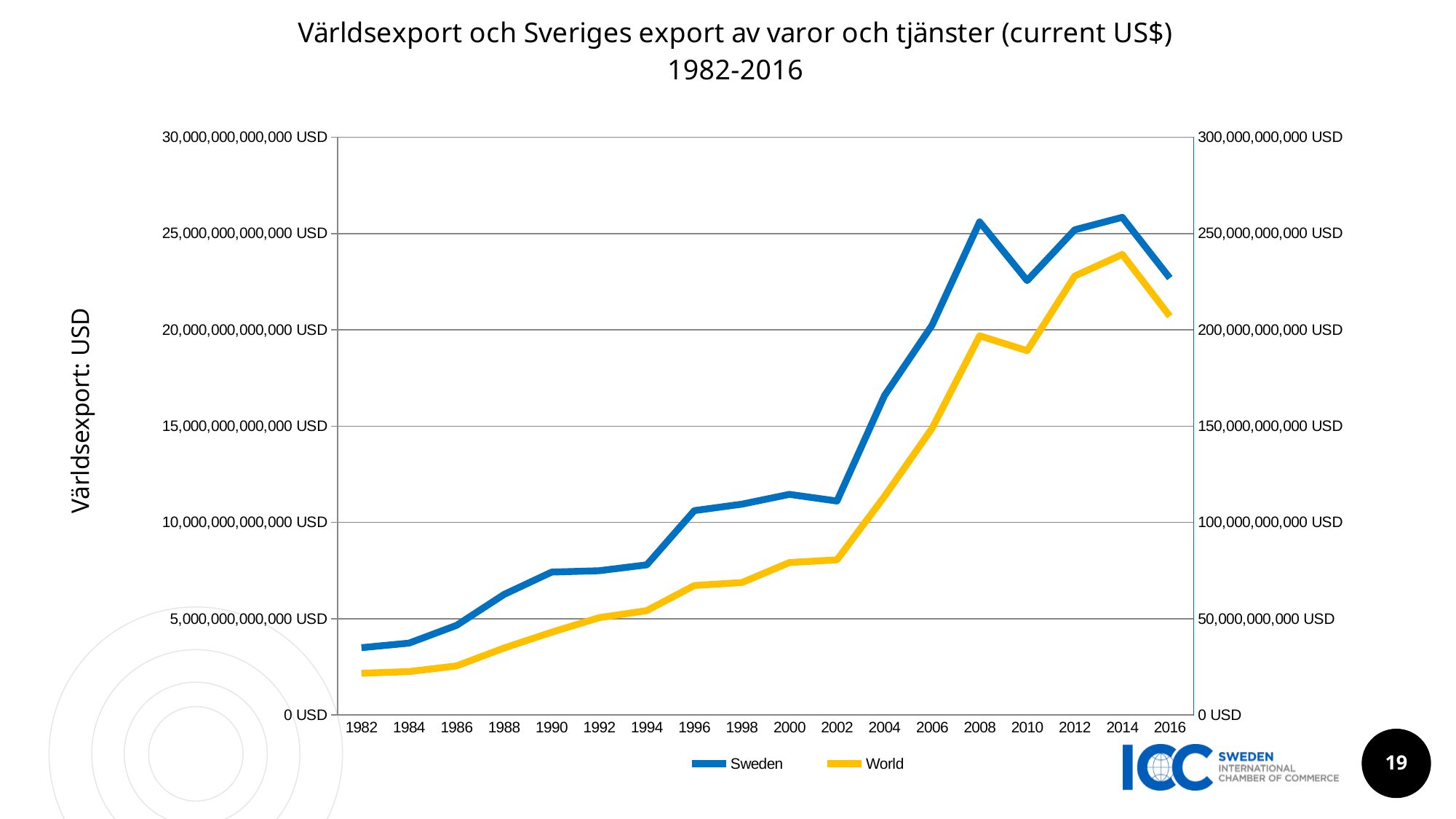
Is the World line in 2002 greater or less than the 10,000,000,000,000 USD gridline on the left axis? less In which year is the World line at its lowest point? 1982 How many years are labelled on the x axis? 18 In which year is the Sweden line at its lowest point? 1982 Does the World line rise or fall between 2014 and 2016? fall In which year does the World line reach its highest point? 2014 How many series does the legend list? 2 What is the title of the chart? Världsexport och Sveriges export av varor och tjänster (current US$) 1982-2016 What kind of chart is shown on the slide? line chart Which line is higher in 2016, Sweden or World? Sweden Which two series are listed in the legend? Sweden and World